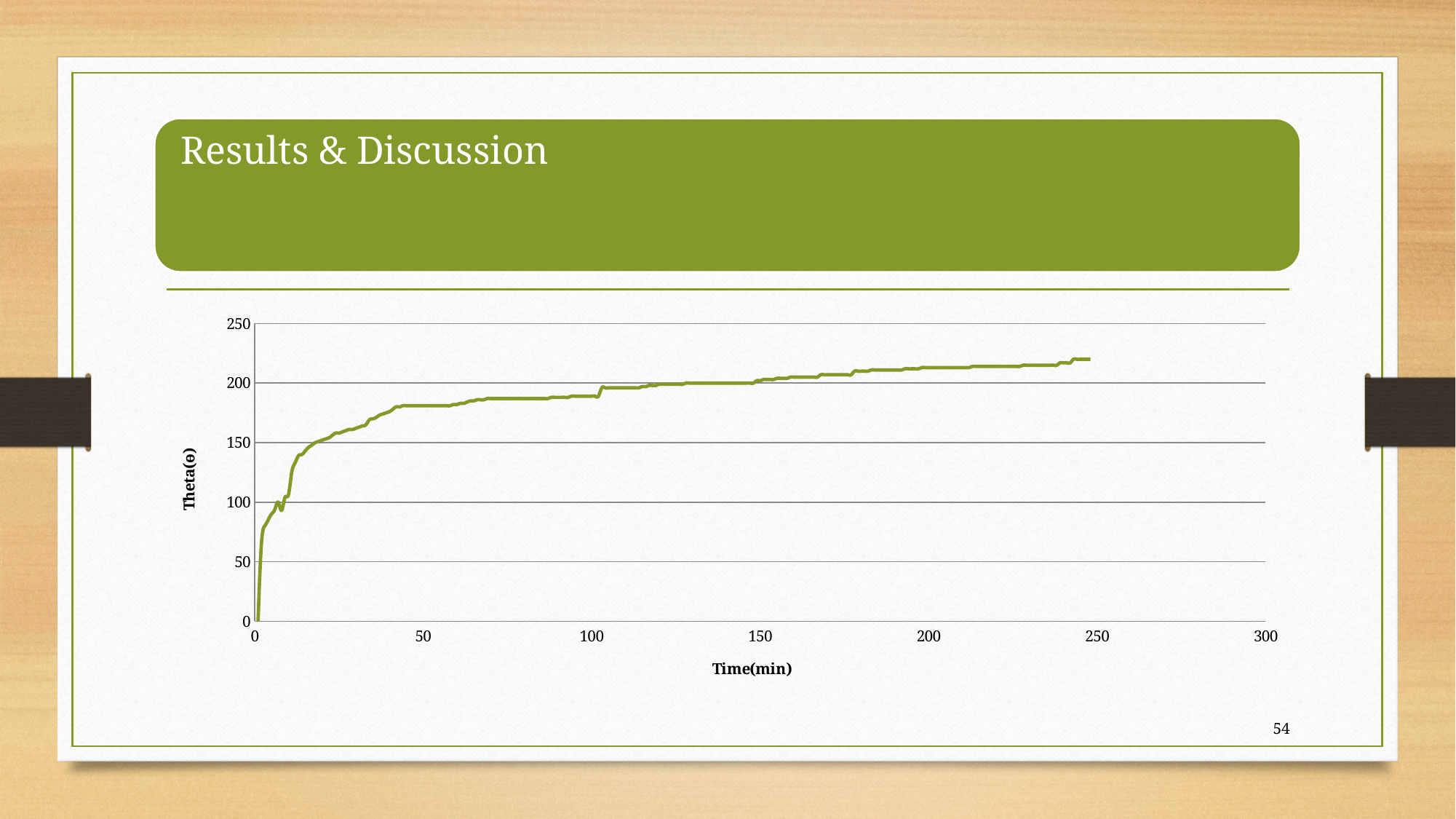
Is the Theta value at 50 min greater or less than 150? greater Is the Theta value at 5 min greater or less than 50? greater Do the Theta values generally rise or fall as time increases? rise What kind of chart is shown on the slide? line chart Does the Theta value ever exceed 250 on the chart? no Is the Theta value at 200 min larger or smaller than the value at 50 min? larger What is the label of the y axis? Theta(θ) How many lines are plotted on the chart? 1 What is the label of the x axis? Time(min)